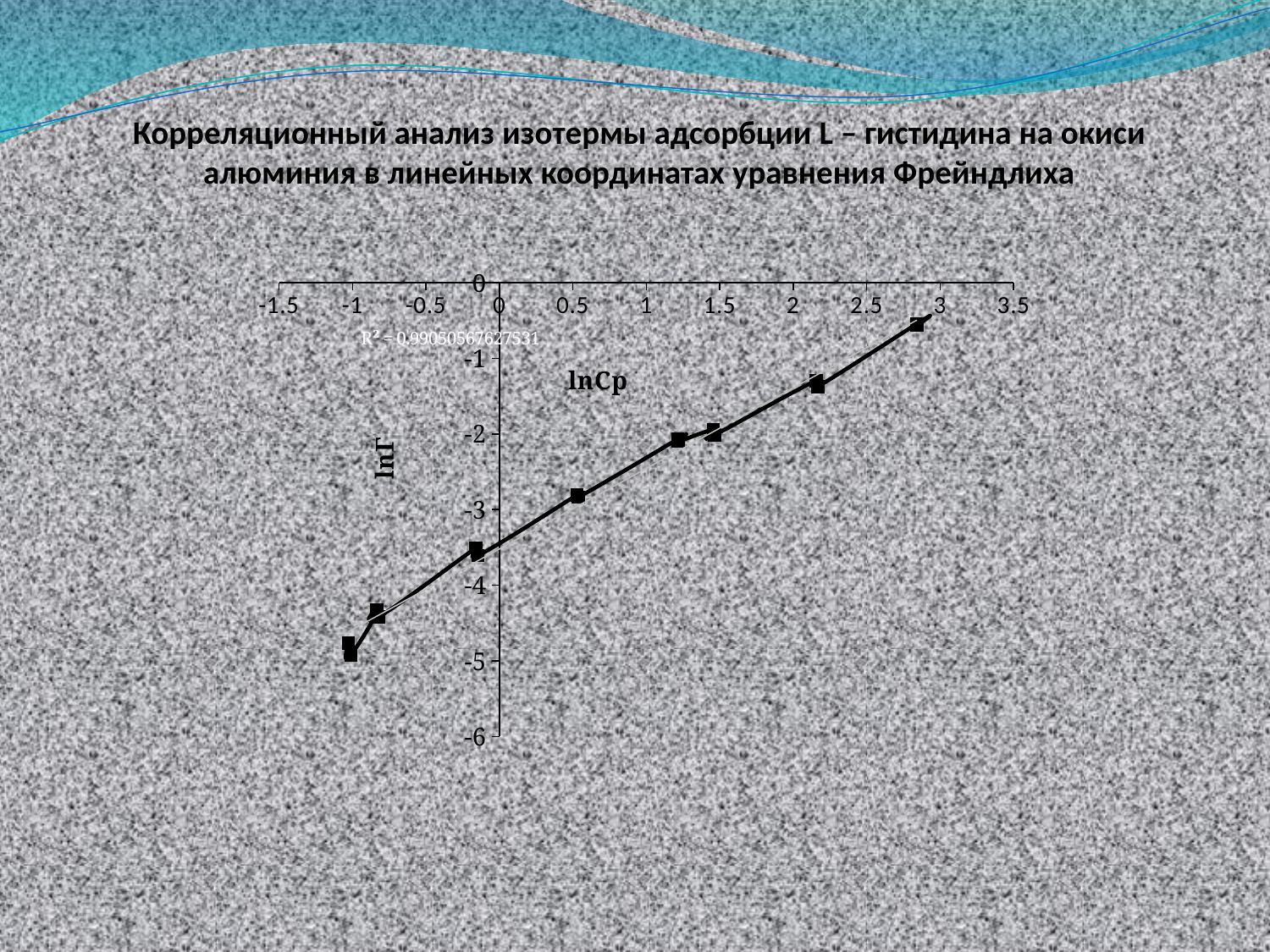
Is the lnГ value of the point near lnCp = 2 greater or less than -2? greater What is the label of the vertical axis? lnГ Which point has the higher lnГ value: the one near lnCp = -1 or the one near lnCp = 3? the one near lnCp = 3 Is the lnГ value of the leftmost point (near lnCp = -1) greater or less than -4? less Do the plotted values rise or fall as lnCp increases along the x axis? rise What is the lowest tick value shown on the vertical axis? -6 Is the lnГ value of the point near lnCp = 0.5 greater or less than -2? less What is the label of the horizontal axis? lnCp What kind of chart is shown on the slide? scatter chart